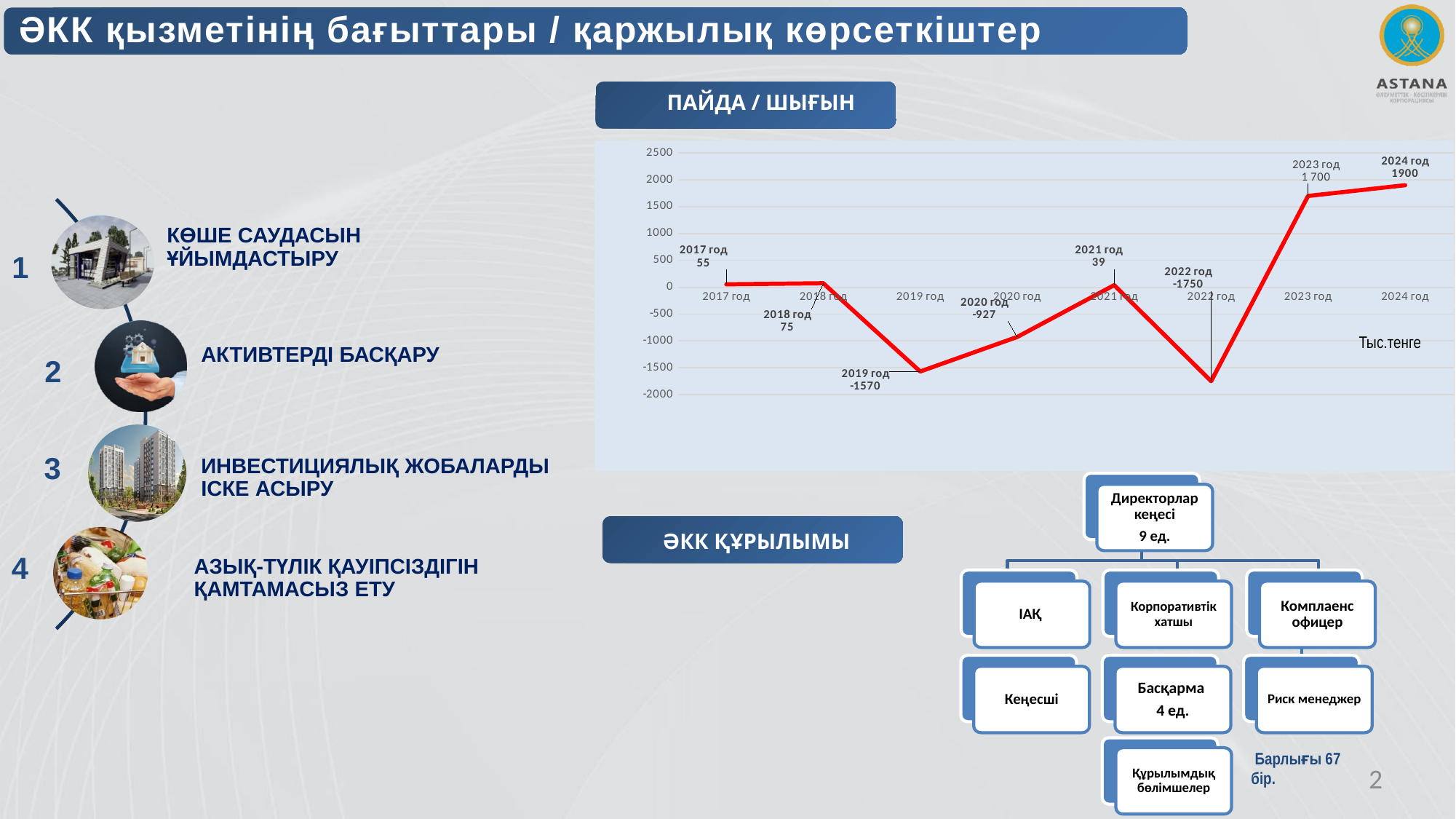
How many years are plotted in the ПАЙДА / ШЫҒЫН chart? 8 Which year has the highest value in the ПАЙДА / ШЫҒЫН chart? 2024 год What is the value for 2020 год in the ПАЙДА / ШЫҒЫН chart? -927 Which year has the lowest value in the ПАЙДА / ШЫҒЫН chart? 2022 год What is the value for 2024 год in the ПАЙДА / ШЫҒЫН chart? 1900 In the ПАЙДА / ШЫҒЫН chart, which is larger: the value for 2017 год or 2018 год? 2018 год What type of chart is the ПАЙДА / ШЫҒЫН chart? line chart What is the value for 2019 год in the ПАЙДА / ШЫҒЫН chart? -1570 In the ПАЙДА / ШЫҒЫН chart, is the value for 2023 год greater or less than 1500? greater In the ПАЙДА / ШЫҒЫН chart, what is the difference between the values for 2024 год and 2023 год? 200 What unit is shown on the ПАЙДА / ШЫҒЫН chart? Тыс.тенге What is the value for 2022 год in the ПАЙДА / ШЫҒЫН chart? -1750